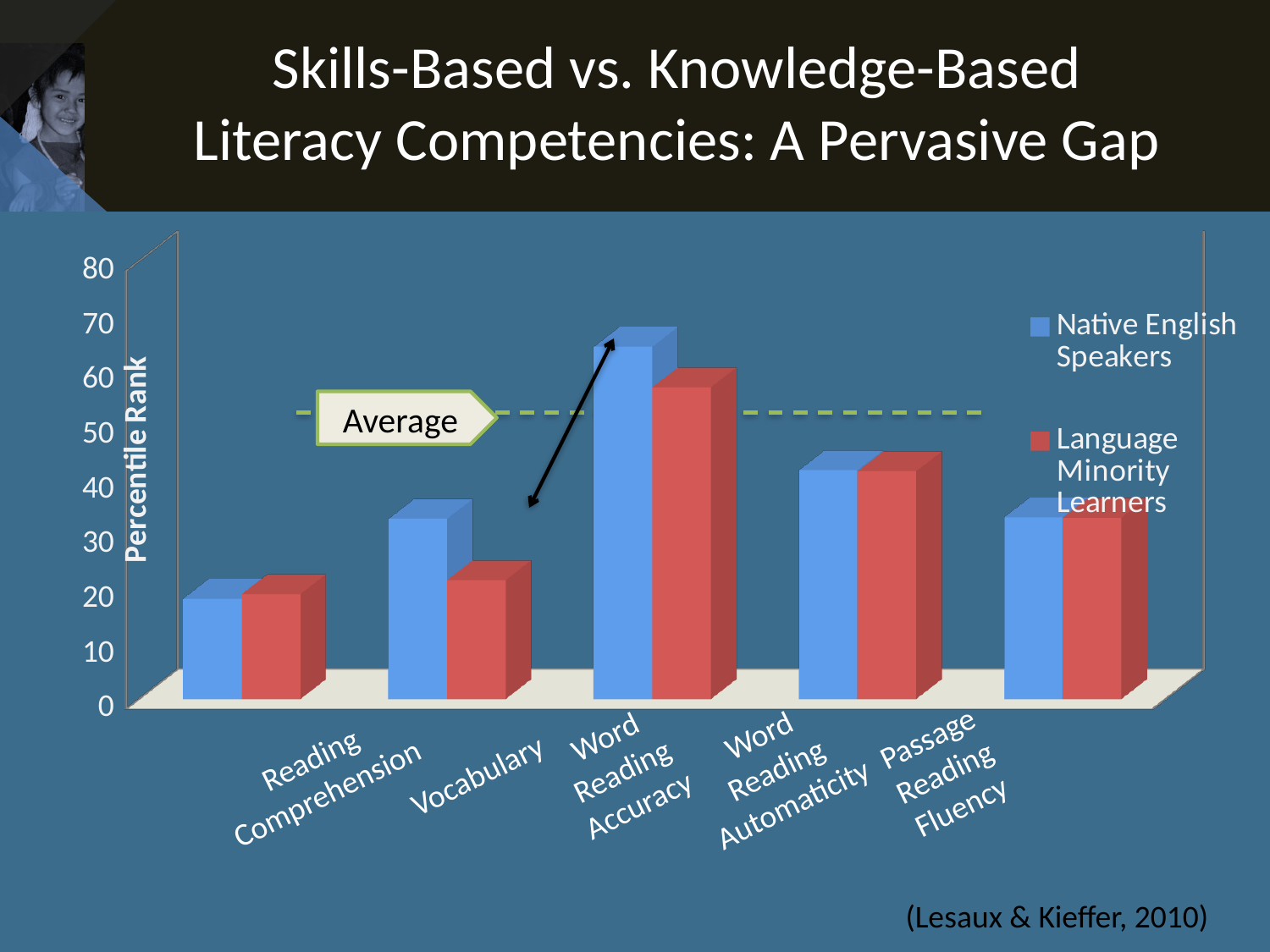
Which category has the lowest value for Native English Speakers? Reading Comprehension Is the value for Native English Speakers in Word Reading Accuracy greater or less than 60? greater What is the title of the chart's vertical axis? Percentile Rank How many series does the chart's legend list? 2 For Vocabulary, which series has the larger value: Native English Speakers or Language Minority Learners? Native English Speakers How many categories are shown on the x axis of the chart? 5 For Word Reading Accuracy, which series has the larger value: Native English Speakers or Language Minority Learners? Native English Speakers Is the value for Native English Speakers in Word Reading Automaticity greater or less than 50? less Which category has the highest value for Native English Speakers? Word Reading Accuracy Is the value for Language Minority Learners in Vocabulary greater or less than 30? less Which category has the highest value for Language Minority Learners? Word Reading Accuracy What kind of chart is shown on the slide? bar chart